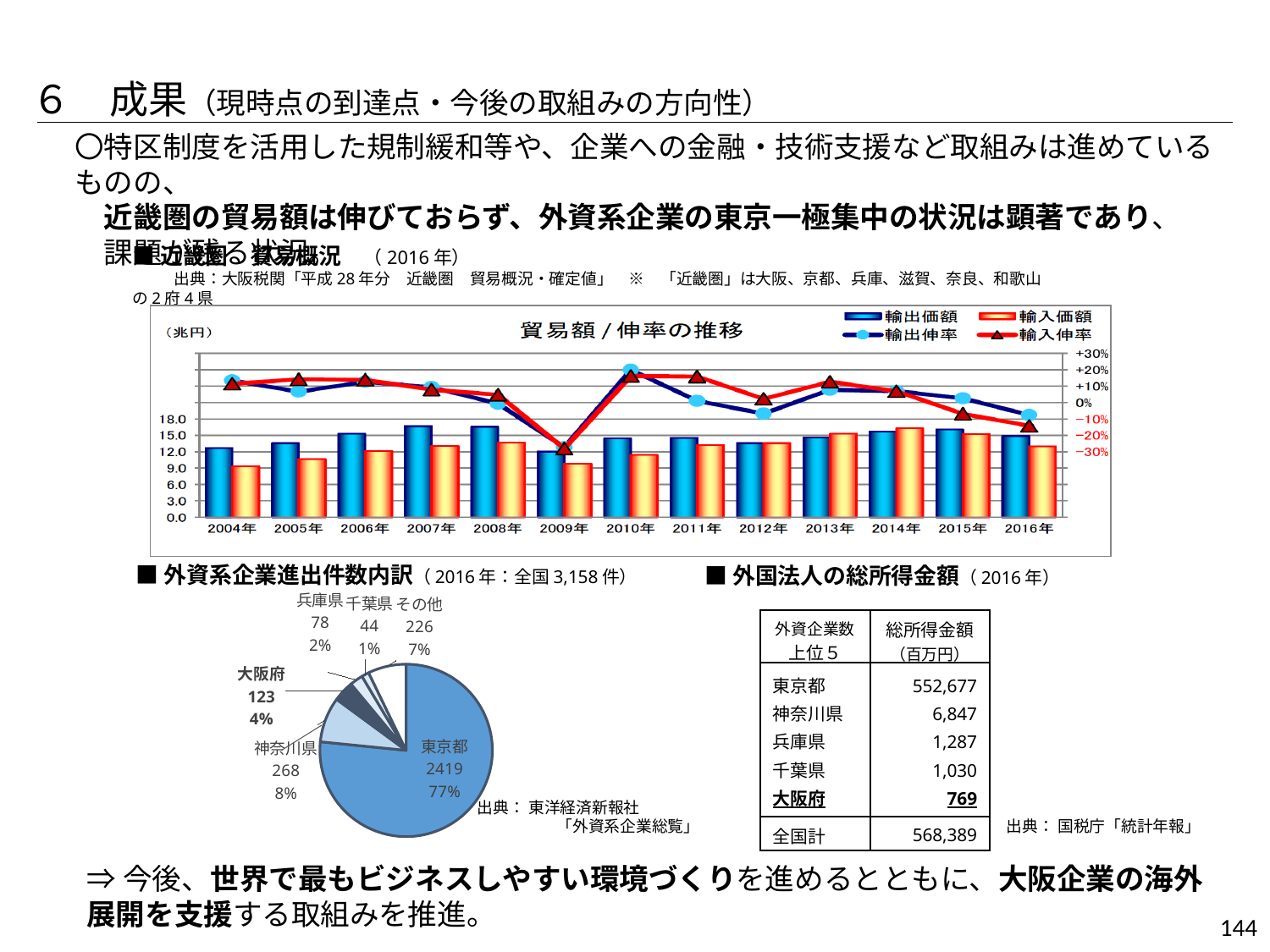
How many years are shown on the x axis of the chart 貿易額/伸率の推移? 13 In the pie chart 外資系企業進出件数内訳, what share of the total does 東京都 account for? 77% In the pie chart 外資系企業進出件数内訳, what is the difference between the values for 東京都 and 神奈川県? 2151 In the chart 貿易額/伸率の推移, is the 輸入価額 value for 2004年 greater or less than 12.0? less In the pie chart 外資系企業進出件数内訳, how many cases are shown for 神奈川県? 268 In the pie chart 外資系企業進出件数内訳, which prefecture has the largest slice? 東京都 How many slices does the pie chart 外資系企業進出件数内訳 have? 6 How many series does the legend of the chart 貿易額/伸率の推移 list? 4 In the pie chart 外資系企業進出件数内訳, which labelled prefecture has the smallest slice? 千葉県 In the pie chart 外資系企業進出件数内訳, what is the value shown for 大阪府? 123 In the chart 貿易額/伸率の推移, is the 輸出価額 value for 2007年 greater or less than 15.0? greater What kind of chart is 外資系企業進出件数内訳? Pie chart